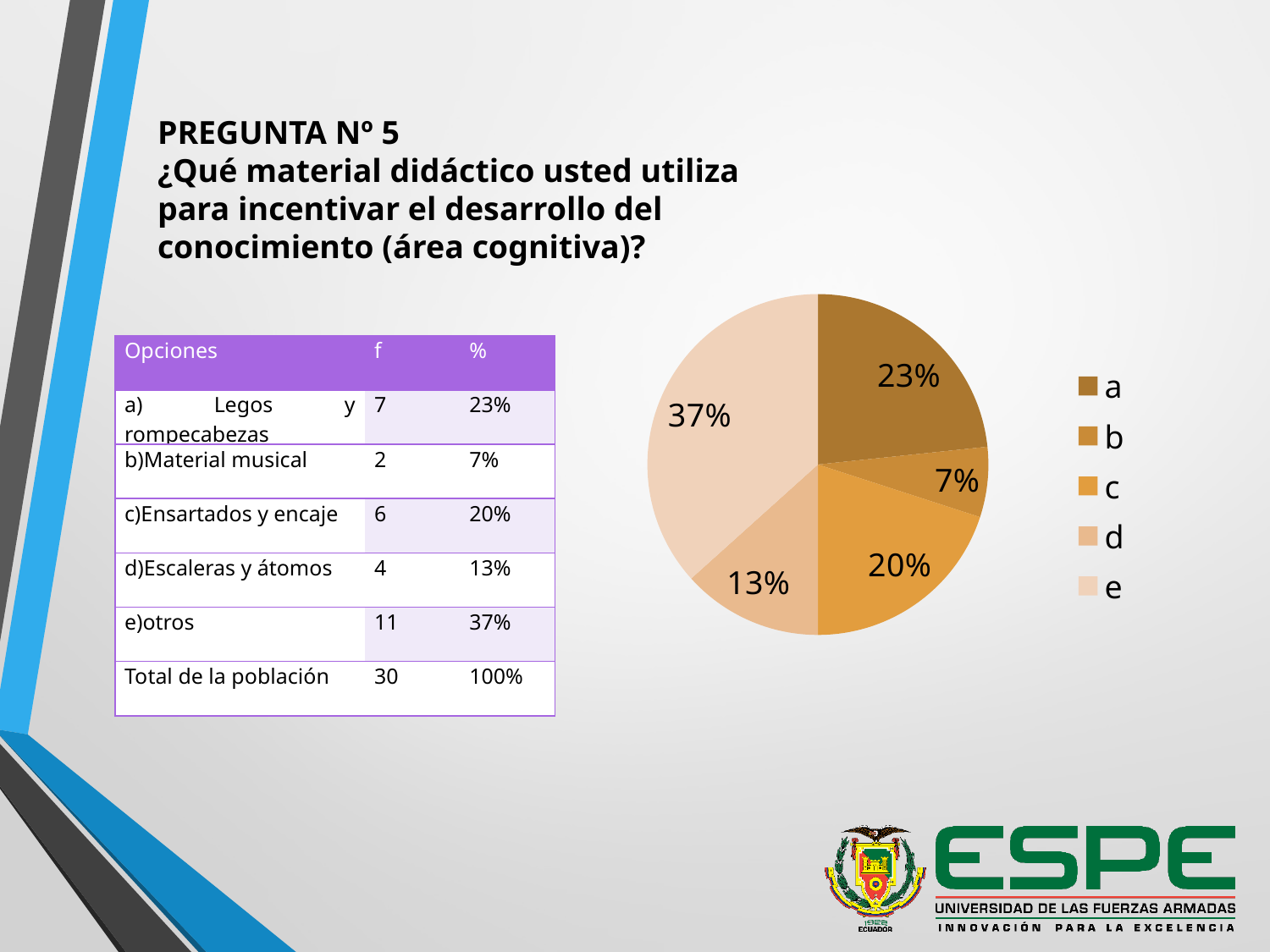
What percentage does slice d show in the pie chart? 13% Which is larger in the pie chart, slice a or slice c? a What kind of chart is shown on the slide? pie chart What percentage does slice c show in the pie chart? 20% What is the difference in percentage points between slice e and slice d in the pie chart? 24 What percentage does slice a show in the pie chart? 23% Which slice of the pie chart is the largest? e How many slices does the pie chart have? 5 What percentage does slice e show in the pie chart? 37% What percentage does slice b show in the pie chart? 7% How many entries does the legend of the pie chart list? 5 Which slice of the pie chart is the smallest? b